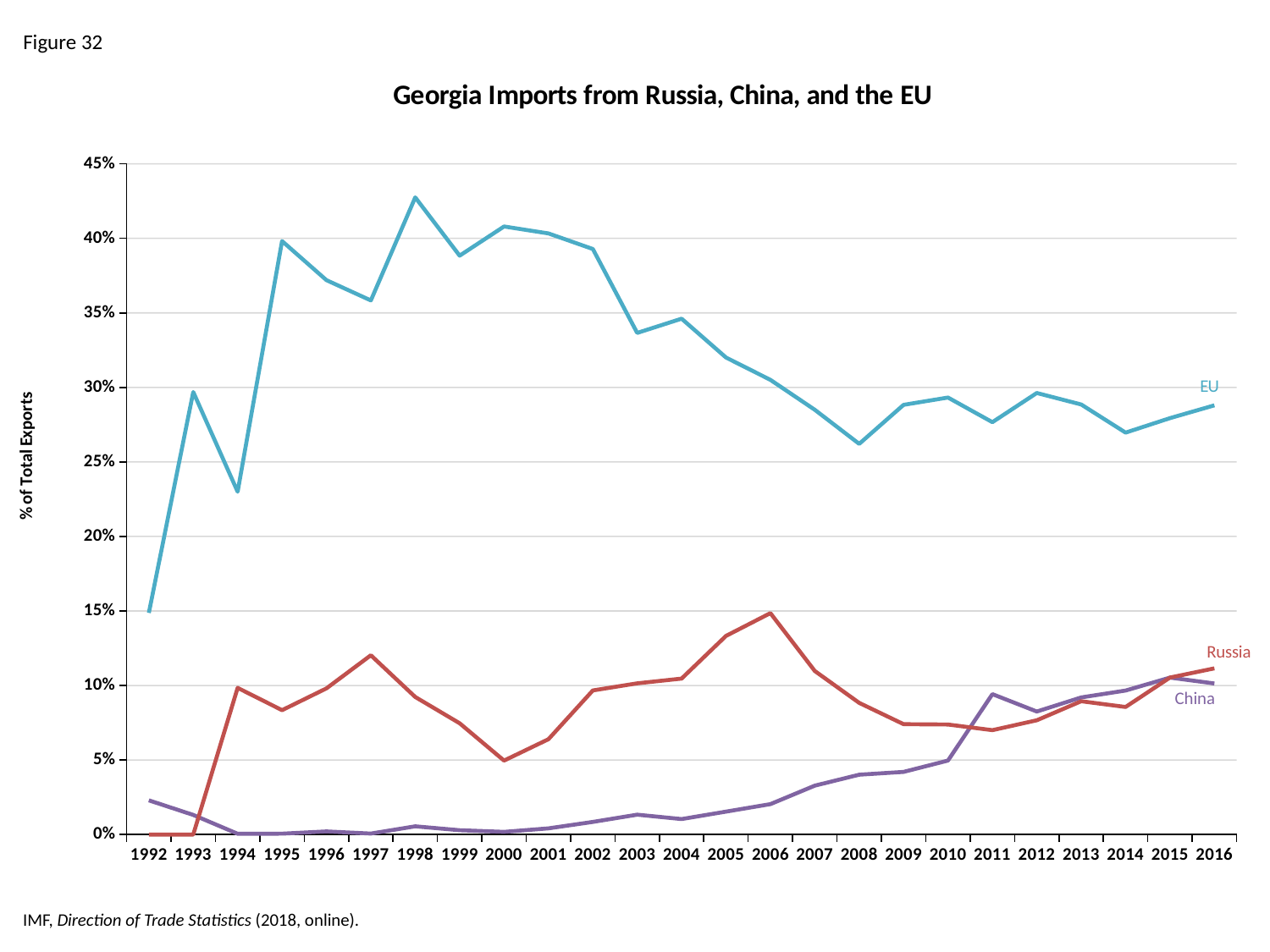
Is the value for the EU in 1998 greater or less than 40%? greater How many series are plotted on the chart? 3 How many years are shown along the x axis? 25 Is the value for China in 2011 greater or less than 5%? greater In which year does the EU series reach its highest value? 1998 In which year does the Russia series reach its highest value? 2006 What is the label on the vertical axis? % of Total Exports Which series has the larger value in 2011, Russia or China? China What kind of chart is shown on the slide? line chart What is the title of the chart? Georgia Imports from Russia, China, and the EU Is the value for the EU in 2008 greater or less than 30%? less In which year is the EU series at its lowest value? 1992